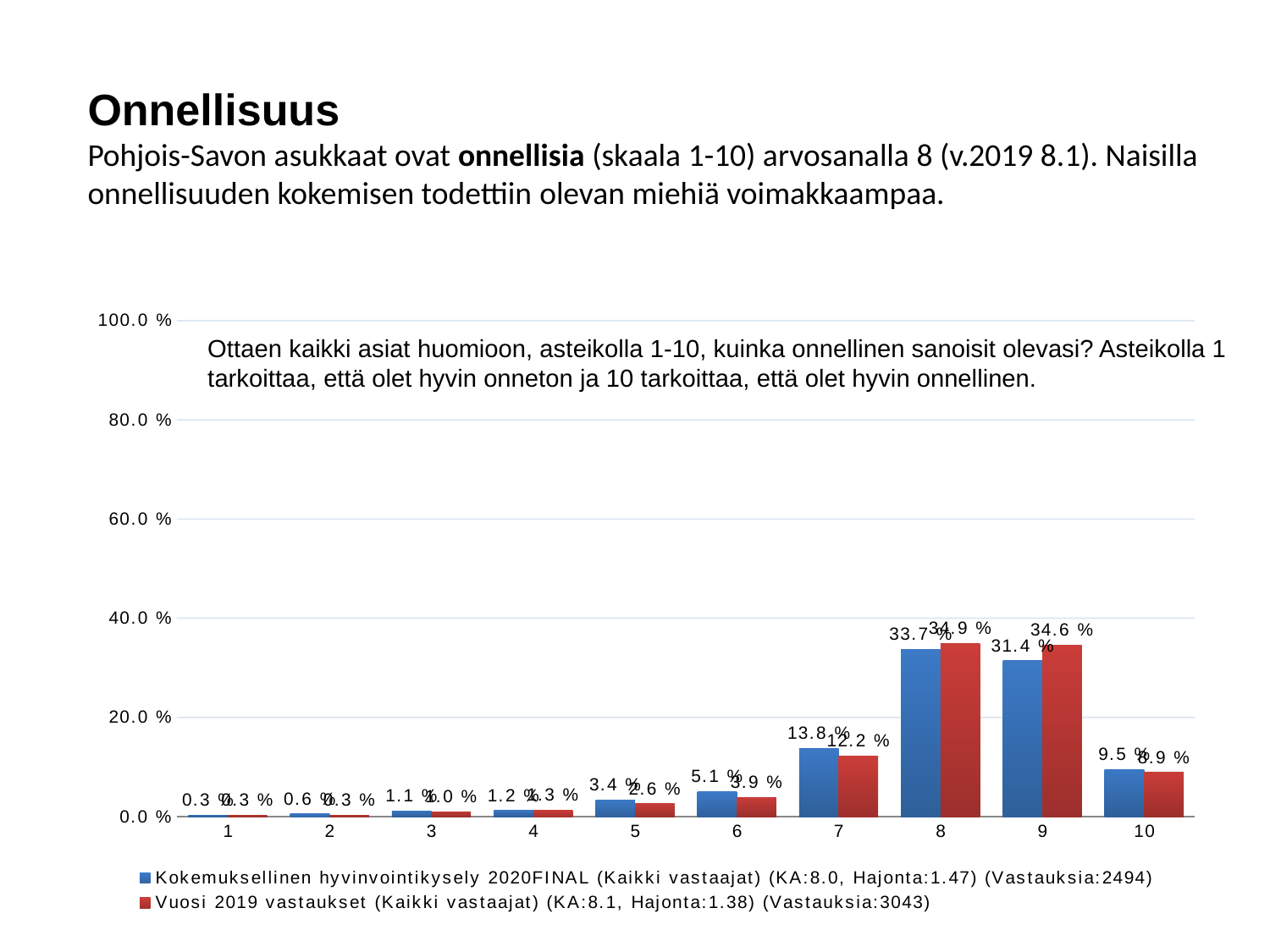
What is the value for category 10 in the 2020 series? 9.5 % Which category has the highest value in the 2020 series? 8 How many categories are shown on the x axis? 10 What kind of chart is shown on the slide? bar chart What is the value for category 9 in the Vuosi 2019 vastaukset series? 34.6 % For category 7, which series has the larger value, 2020 or Vuosi 2019? 2020 Is the 2020 value for category 8 greater or less than 20.0 %? greater How many series does the legend list? 2 What is the difference between the 2020 and 2019 values for category 7? 1.6 % What is the value for category 7 in the 2020 series (Kokemuksellinen hyvinvointikysely 2020FINAL)? 13.8 % What is the difference between the 2019 and 2020 values for category 9? 3.2 % For category 9, which series has the larger value, 2020 or Vuosi 2019? Vuosi 2019